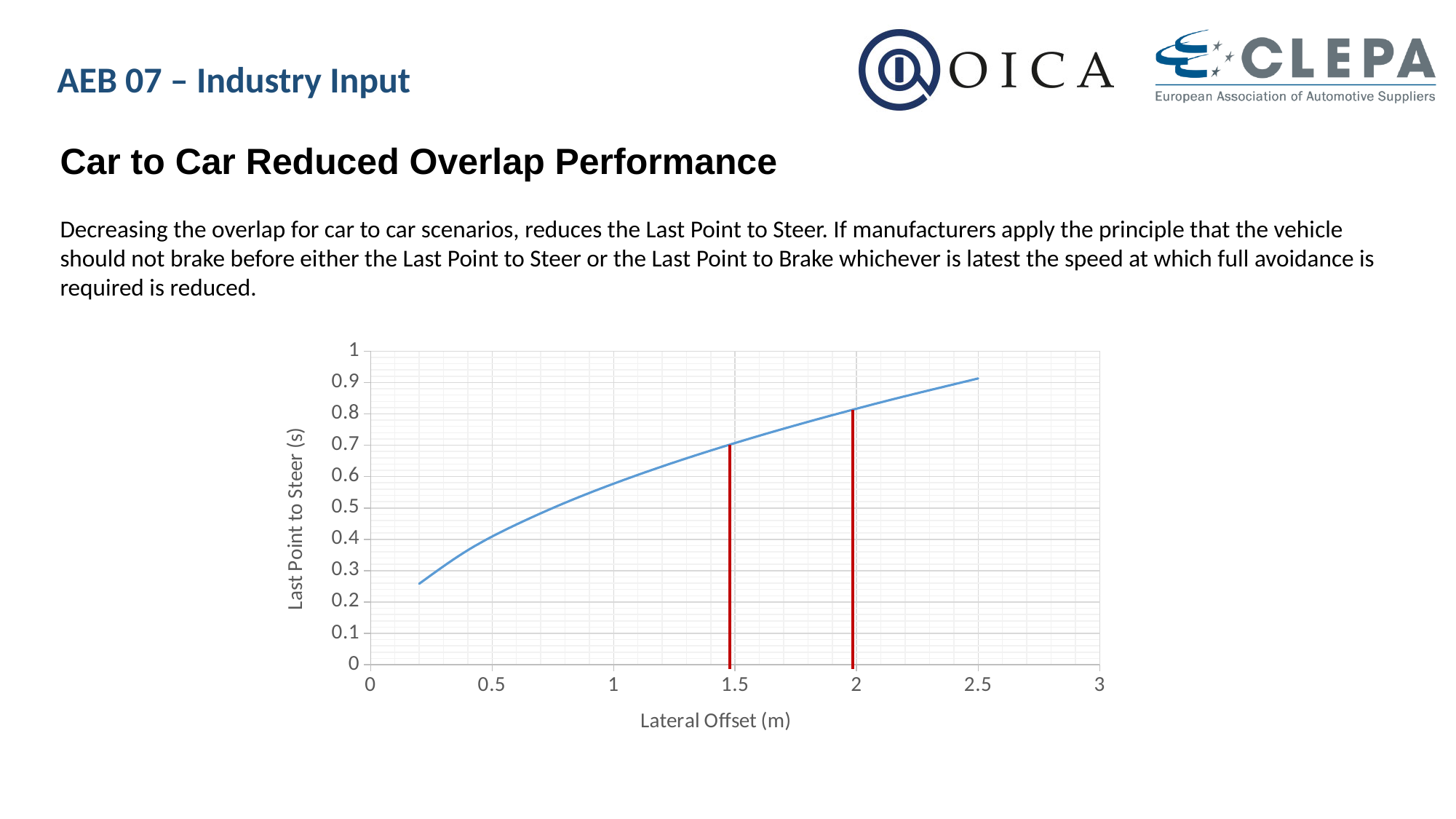
Is the Last Point to Steer at a Lateral Offset of 1.5 m greater or less than 0.6? greater Is the Last Point to Steer at a Lateral Offset of 0.5 m greater or less than 0.5? less Is the Last Point to Steer at a Lateral Offset of 1 m greater or less than 0.5? greater What kind of chart is shown on the slide? line chart What is the label of the y axis of the chart? Last Point to Steer (s) Does the Last Point to Steer rise or fall as the Lateral Offset increases? rise What is the label of the x axis of the chart? Lateral Offset (m)